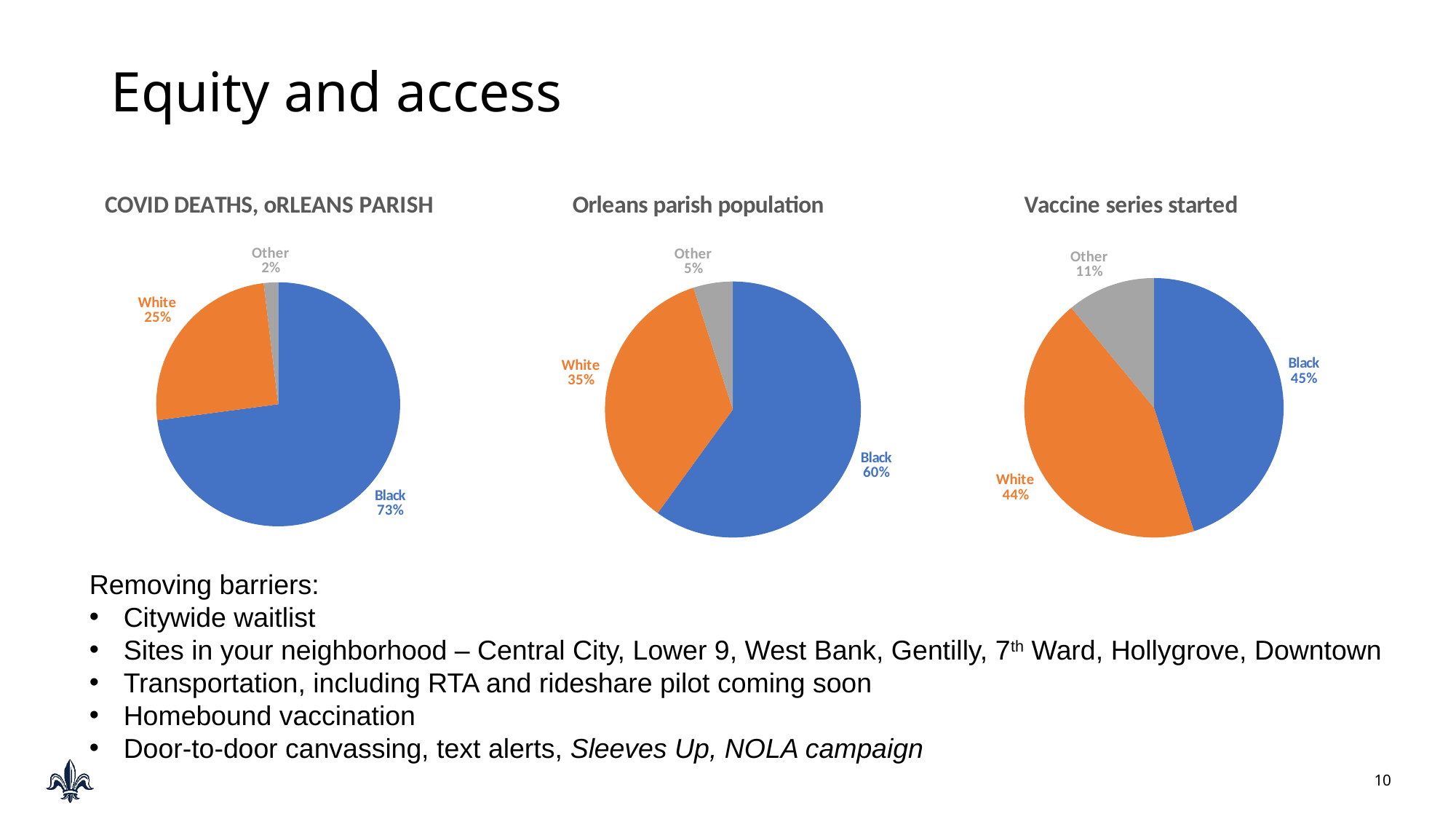
How many charts are shown on the slide? 3 In the 'COVID DEATHS, oRLEANS PARISH' chart, what is the value for White? 25% How many categories does the 'Orleans parish population' chart show? 3 In the 'Vaccine series started' chart, which category is the smallest? Other Is the Black share larger in the 'COVID DEATHS, oRLEANS PARISH' chart or in the 'Vaccine series started' chart? COVID DEATHS, oRLEANS PARISH In the 'COVID DEATHS, oRLEANS PARISH' chart, what share of the pie is Black? 73% In the 'Orleans parish population' chart, what is the value for Other? 5% In the 'Vaccine series started' chart, what is the difference between the Black and White shares? 1% In the 'Orleans parish population' chart, which category is the largest? Black In the 'COVID DEATHS, oRLEANS PARISH' chart, what is the difference between the Black and White shares? 48% What kind of chart is 'Vaccine series started'? Pie chart In the 'Vaccine series started' chart, what is the value for White? 44%